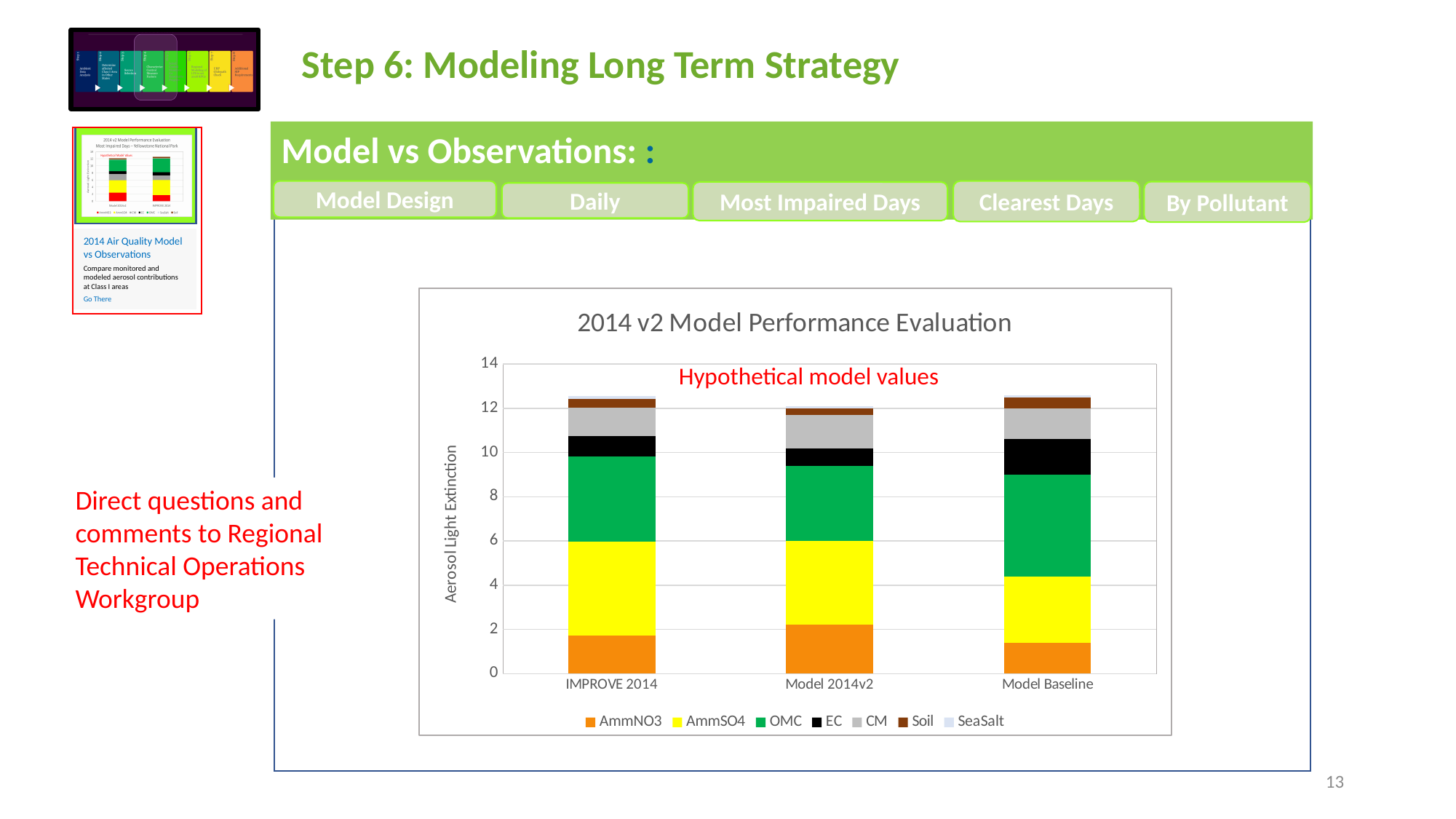
Is the AmmNO3 value for Model 2014v2 greater or less than 2? greater Is the AmmSO4 segment larger for IMPROVE 2014 or for Model Baseline? IMPROVE 2014 What type of chart is shown on the slide? Stacked bar chart Is the total stacked value for IMPROVE 2014 greater or less than 12? greater What is the title of the chart? 2014 v2 Model Performance Evaluation How many categories are shown on the x axis of the chart? 3 How many series does the chart legend list? 7 What is the label of the y axis of the chart? Aerosol Light Extinction Which category has the largest OMC segment? Model Baseline Is the total stacked value for Model Baseline greater or less than 14? less Which category has the largest AmmNO3 segment? Model 2014v2